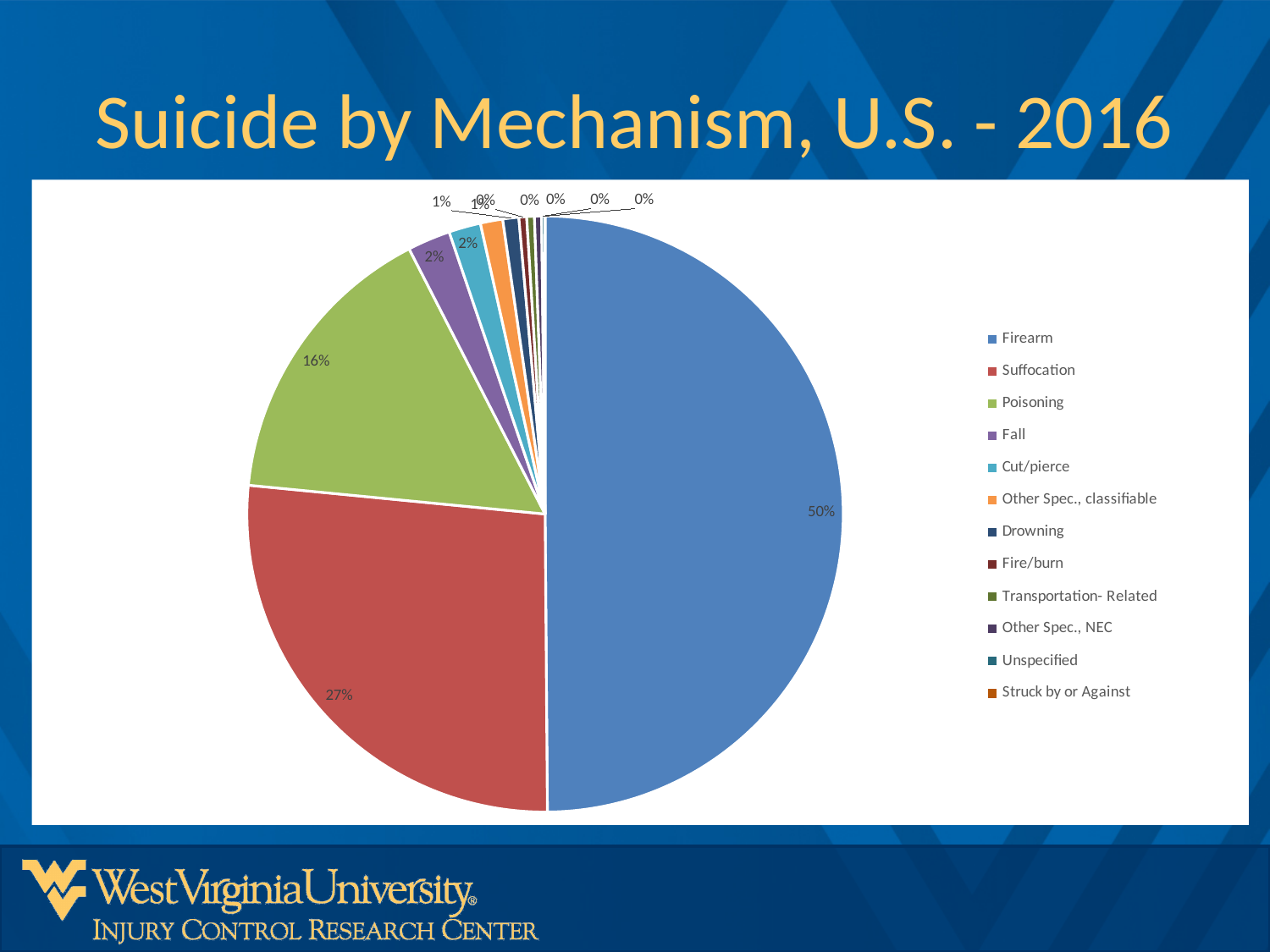
What colour is the Firearm slice? Blue What percentage of suicides is attributed to Poisoning? 16% Which mechanism accounts for the largest share of the pie? Firearm How many mechanism categories are listed in the legend? 12 What is the title of the chart? Suicide by Mechanism, U.S. - 2016 What percentage of suicides is attributed to Fall? 2% How many percentage points larger is the Firearm share than the Suffocation share? 23 percentage points What percentage of suicides is attributed to Firearm? 50% Which has a larger share, Suffocation or Poisoning? Suffocation What kind of chart is shown on the slide? Pie chart What percentage of suicides is attributed to Suffocation? 27% How many percentage points larger is the Suffocation share than the Poisoning share? 11 percentage points